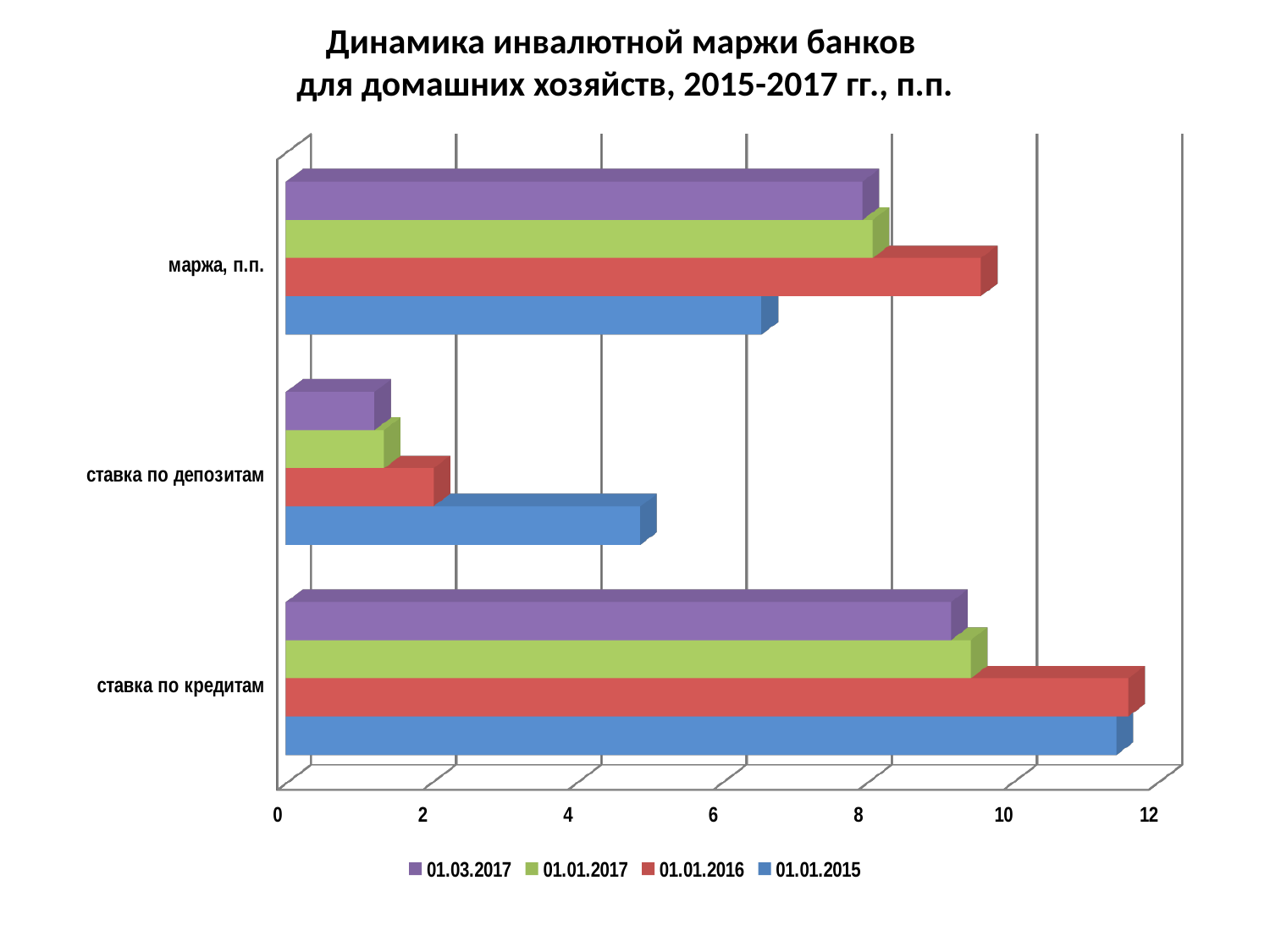
Which colour represents the 01.01.2015 series in the legend? blue Is the value for маржа, п.п. on 01.01.2015 greater or less than 8? less Which series has the highest value for маржа, п.п.? 01.01.2016 How many categories are shown on the vertical axis? 3 Is the value for ставка по депозитам on 01.01.2015 greater or less than 4? greater Is the value for ставка по депозитам on 01.01.2016 greater or less than 4? less For ставка по депозитам, which is larger: the value for 01.01.2015 or the value for 01.01.2016? 01.01.2015 What kind of chart is shown on the slide? bar chart Which series has the highest value for ставка по депозитам? 01.01.2015 How many series does the legend list? 4 Which series has the lowest value for маржа, п.п.? 01.01.2015